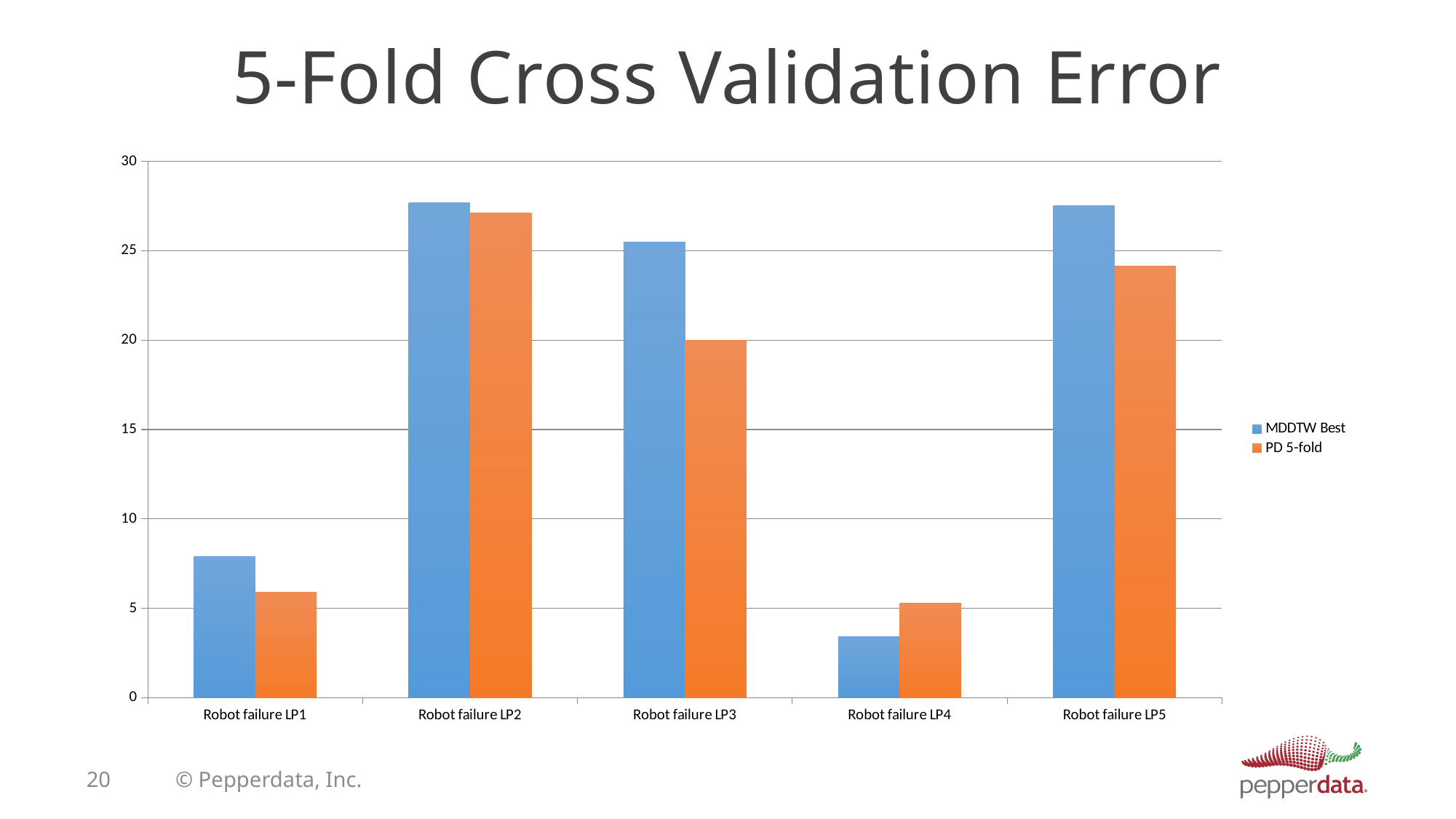
Is the MDDTW Best value for Robot failure LP3 greater or less than 25? greater Is the PD 5-fold value for Robot failure LP5 greater or less than 25? less For Robot failure LP3, which series has the larger value, MDDTW Best or PD 5-fold? MDDTW Best Which category has the lowest MDDTW Best value? Robot failure LP4 For Robot failure LP4, which series has the larger value, MDDTW Best or PD 5-fold? PD 5-fold Is the MDDTW Best value for Robot failure LP1 greater or less than 10? less Which category has the highest PD 5-fold value? Robot failure LP2 What kind of chart is shown on the slide? Bar chart What colour represents the PD 5-fold series in the legend? Orange What is the title of the chart? 5-Fold Cross Validation Error How many categories are shown on the x axis? 5 How many series does the legend list? 2